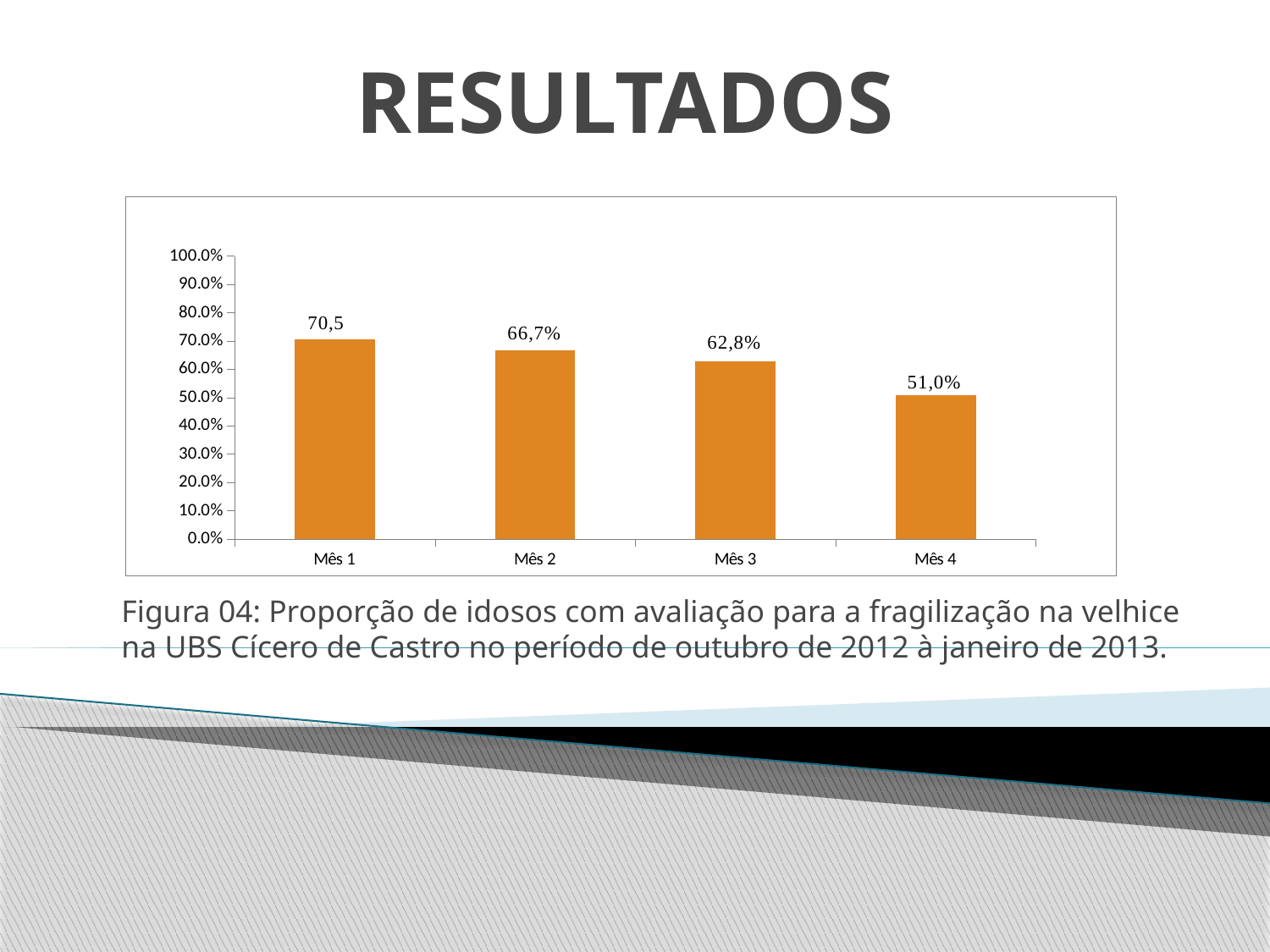
What value is shown for Mês 2? 66,7% What value is shown for Mês 3? 62,8% Do the values rise or fall from Mês 1 to Mês 4? Fall What is the difference between the values for Mês 2 and Mês 3? 3,9 Which is larger, the value for Mês 2 or the value for Mês 4? Mês 2 What kind of chart is this? Bar chart What value is shown for Mês 4? 51,0% Which month has the lowest value? Mês 4 Which month has the highest value? Mês 1 How many months are shown on the x axis? 4 What is the difference between the values for Mês 1 and Mês 4? 19,5 What value is shown for Mês 1? 70,5